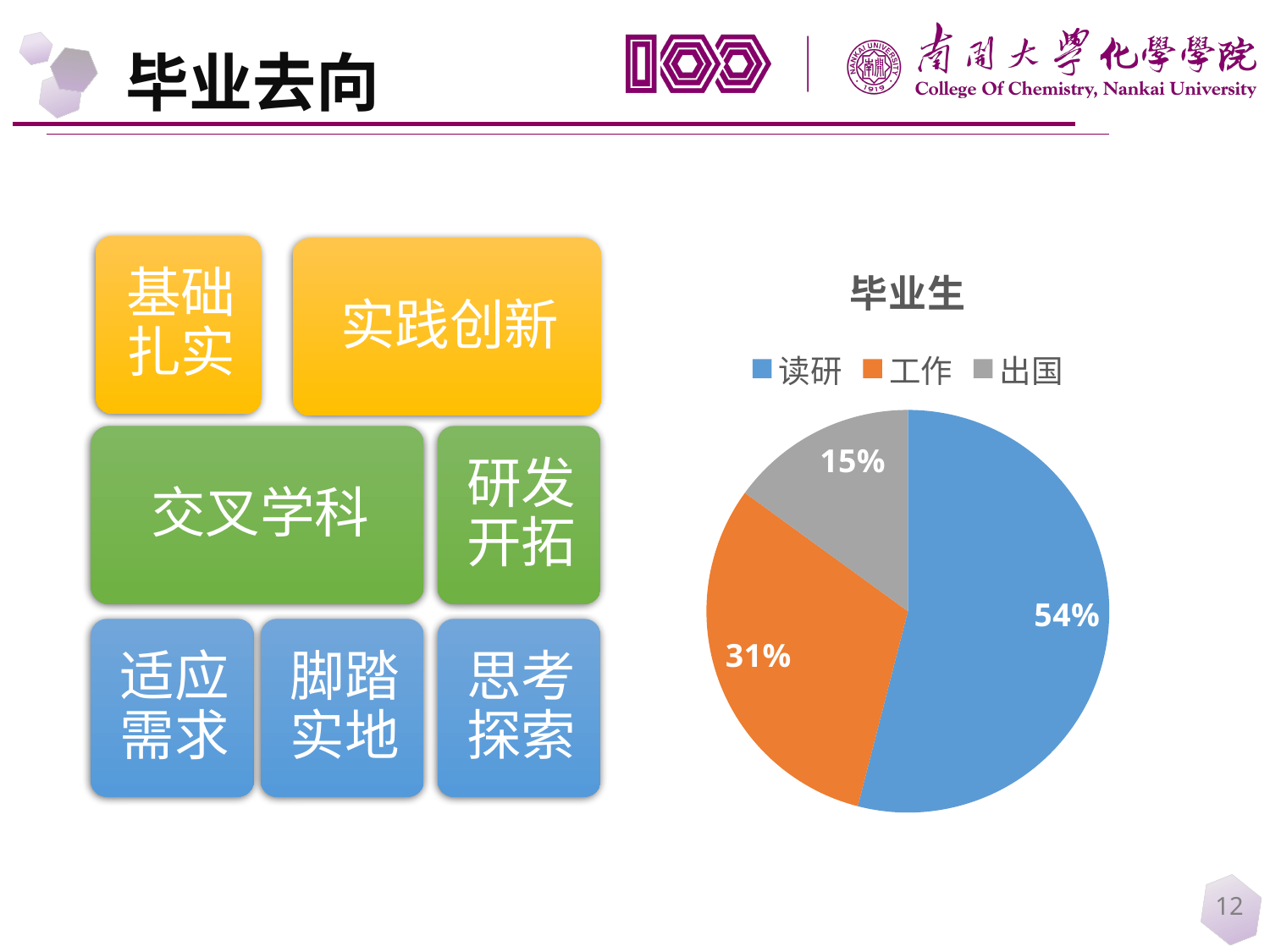
What kind of chart is shown on the slide? pie chart Which category has the smallest slice of the pie? 出国 Which category has the largest slice of the pie? 读研 What share of the pie does 出国 represent? 15% What is the difference between the shares for 读研 and 工作? 23% How many categories does the pie chart show? 3 How many entries does the legend list? 3 What share of the pie does 工作 represent? 31% What is the title of the pie chart? 毕业生 Which is larger, the share for 工作 or the share for 出国? 工作 What share of the pie does 读研 represent? 54% What colour is the 读研 slice in the pie chart? blue